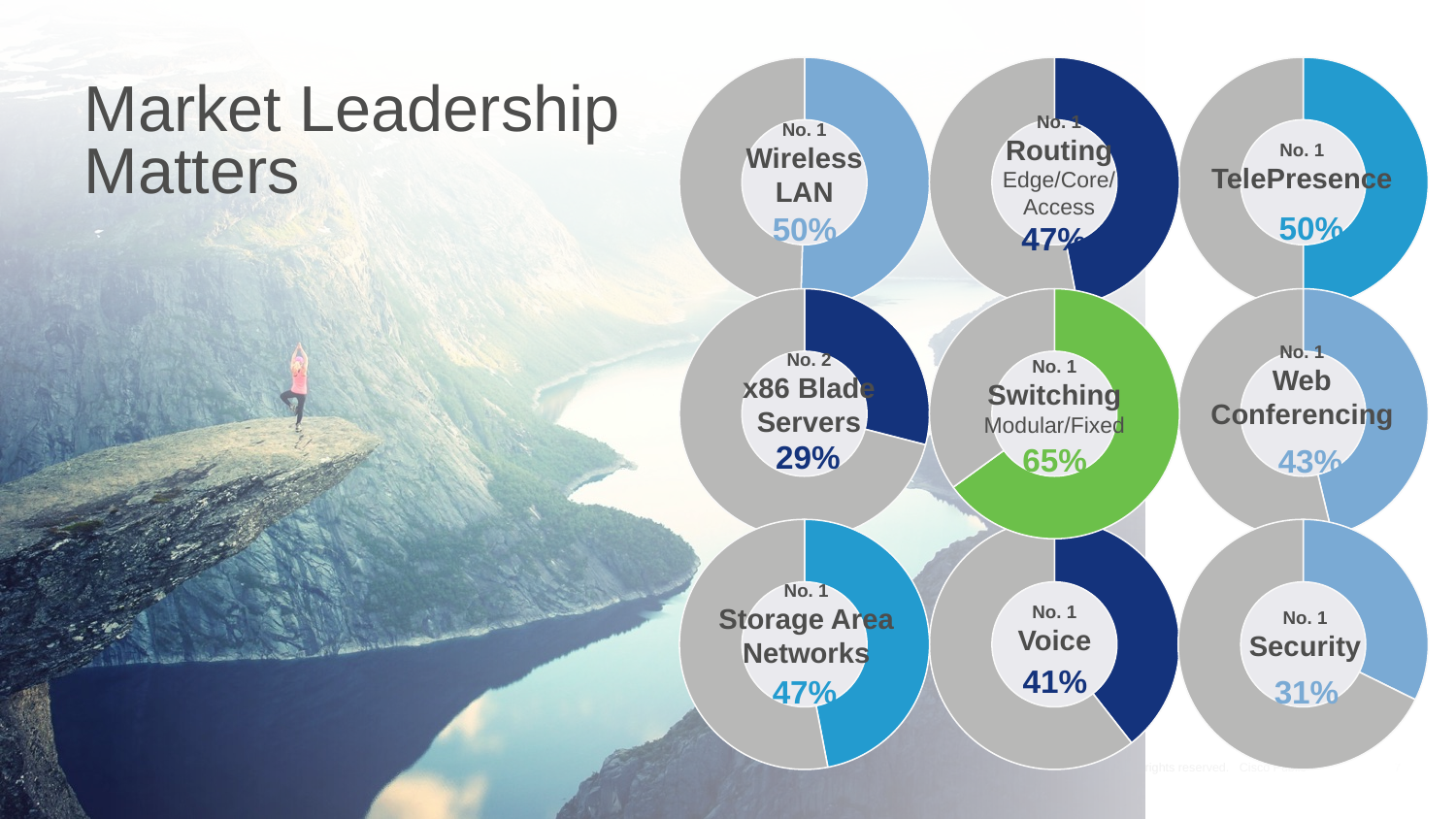
Which shows a larger share, the Web Conferencing chart or the Security chart? Web Conferencing In the Security chart, what percentage is shown? 31% How many donut charts are shown on the slide? 9 In the Wireless LAN chart, what percentage is shown? 50% Which market on the slide is labelled No. 2 rather than No. 1? x86 Blade Servers Across all the donut charts on the slide, which market has the highest share shown? Switching (Modular/Fixed) What is the difference between the share shown in the Switching chart and the share shown in the x86 Blade Servers chart? 36% What kind of chart is used for each market on the slide? Donut (pie) chart In the Voice chart, what percentage is shown? 41% Across all the donut charts on the slide, which market has the lowest share shown? x86 Blade Servers In the Switching (Modular/Fixed) chart, what share is shown? 65% What is the difference between the share in the Storage Area Networks chart and the share in the Voice chart? 6%